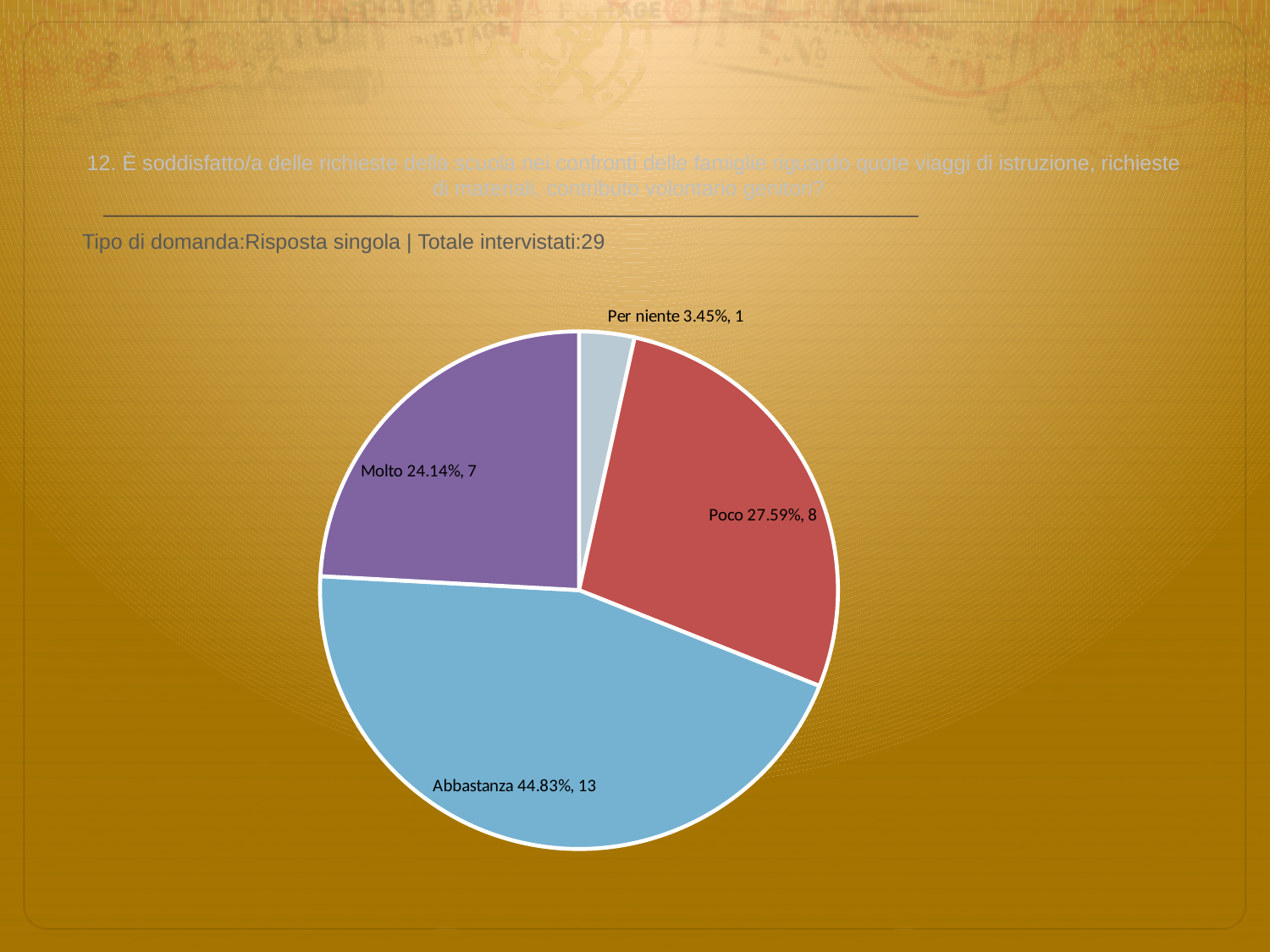
Which category has the smallest slice? Per niente What is the total number of respondents across all slices? 29 What is the difference in count between 'Abbastanza' and 'Poco'? 5 What percentage share does the 'Per niente' slice have? 3.45% Which category has the largest slice? Abbastanza How many slices does the pie chart have? 4 How many respondents answered 'Poco'? 8 What kind of chart is shown on the slide? pie chart What percentage share does the 'Abbastanza' slice have? 44.83% How many respondents answered 'Molto'? 7 Which is larger, the 'Poco' slice or the 'Molto' slice? Poco What colour is the 'Abbastanza' slice? blue